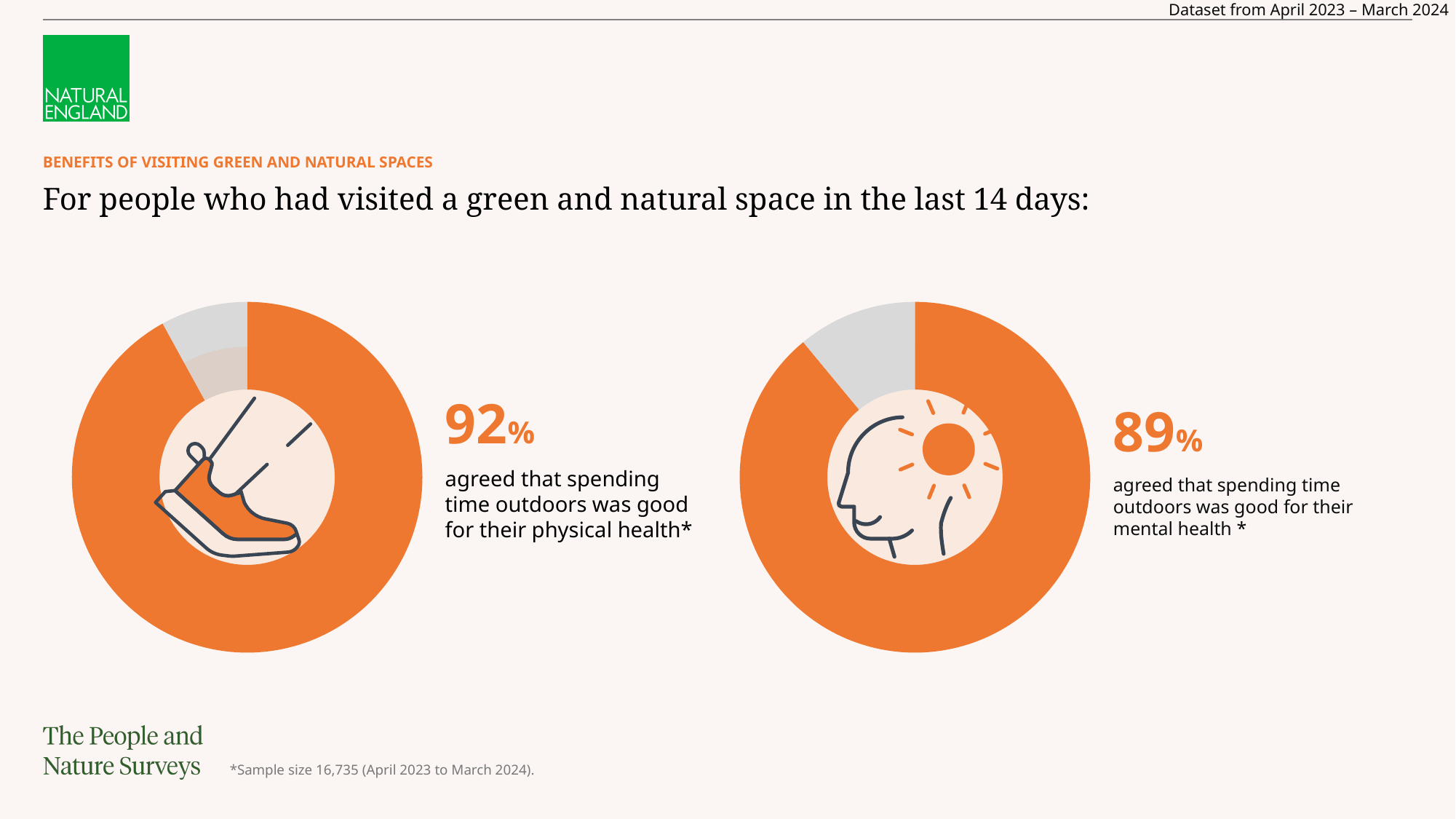
How many donut charts are shown on the slide? 2 What is the difference in percentage points between the left chart's 92% and the right chart's 89%? 3 percentage points On the left chart, what percentage agreed that spending time outdoors was good for their physical health? 92% What colour is used for the 'agreed' portion of both donut charts? orange Is the value shown on the left chart (physical health) greater or less than 90%? greater On the right chart, what percentage agreed that spending time outdoors was good for their mental health? 89% What sample size is given in the footnote for the charts? 16,735 What kind of chart is used on the left of the slide to show the physical health result? donut (pie) chart On the left chart, what share of the donut is not coloured orange (the grey remainder)? 8% Which is larger: the percentage agreeing outdoors was good for physical health (left chart) or for mental health (right chart)? physical health Is the value shown on the right chart (mental health) greater or less than 90%? less